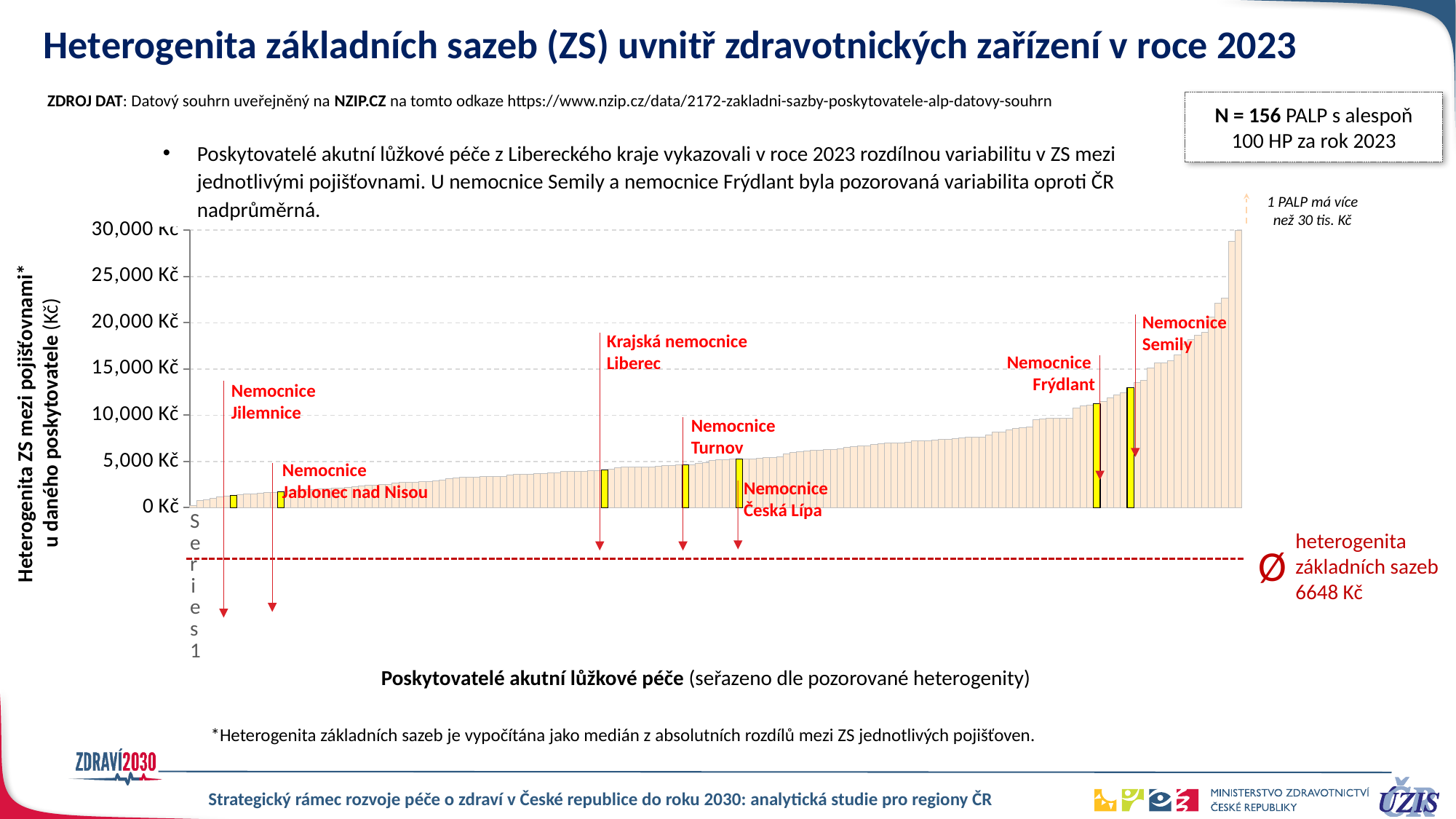
Which of the highlighted Liberec region hospitals has the lowest heterogeneity value? Nemocnice Jilemnice Which of the highlighted Liberec region hospitals has the highest heterogeneity value? Nemocnice Semily What is the highest value shown on the y axis of the chart? 30,000 Kč What kind of chart is shown on the slide? bar chart How many acute inpatient care providers (PALP) are included in the chart according to the slide? 156 Which has a larger heterogeneity value, Nemocnice Frýdlant or Nemocnice Jablonec nad Nisou? Nemocnice Frýdlant Do the bar values rise or fall from left to right along the x axis? rise What is the average heterogeneity of base rates (heterogenita základních sazeb) marked by the dashed red line? 6648 Kč Is the value for Krajská nemocnice Liberec greater or less than 5,000 Kč? less Is the value for Nemocnice Jilemnice greater or less than 5,000 Kč? less Is the value for Nemocnice Semily greater or less than 10,000 Kč? greater How many hospitals are highlighted in yellow and labelled in red on the chart? 7